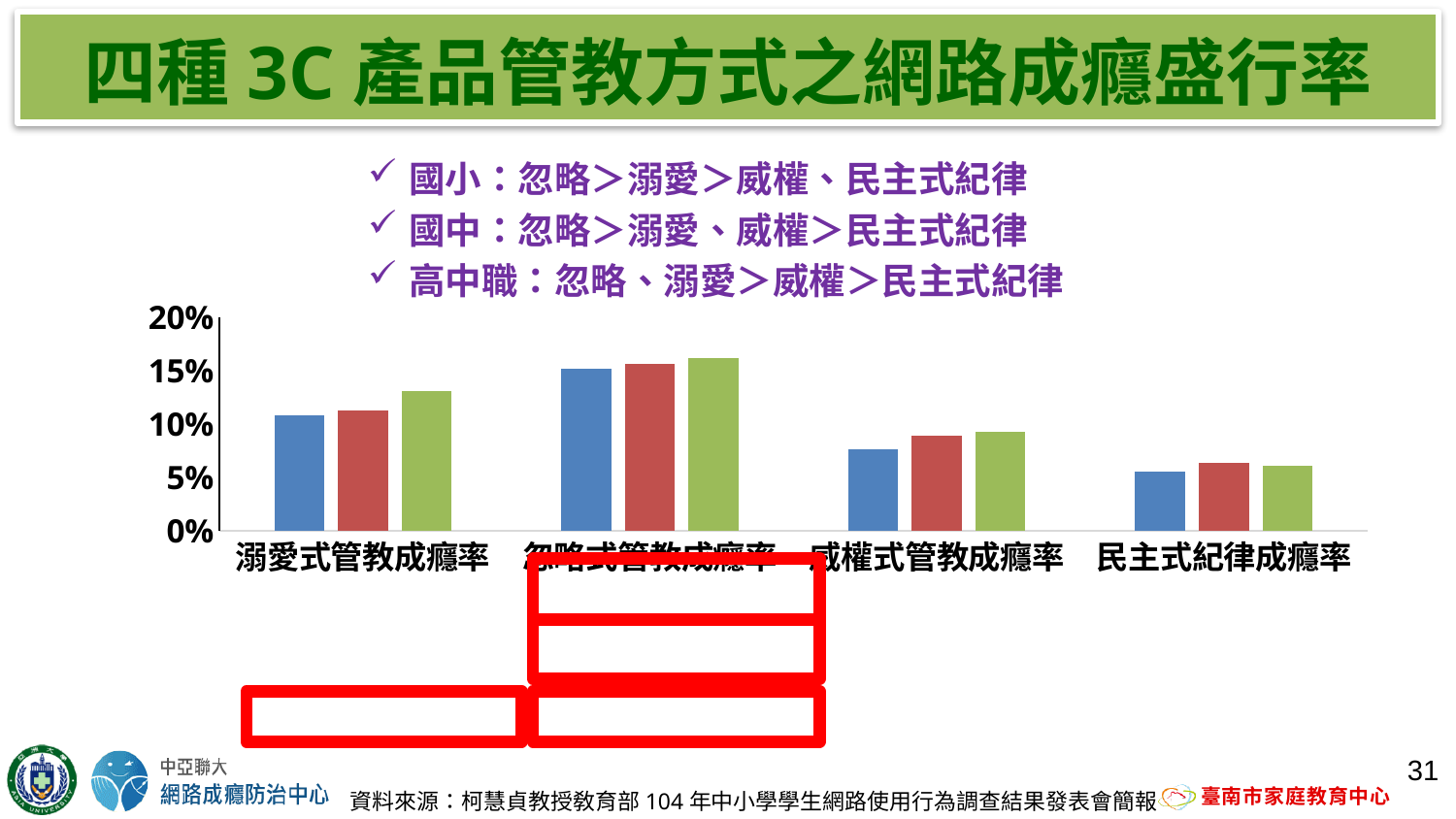
Is the red bar for 民主式紀律成癮率 greater or less than 10%? less Is the green bar for 溺愛式管教成癮率 greater or less than 15%? less Which category has the highest bars in the chart? 忽略式管教成癮率 Which is larger: the green bar for 忽略式管教成癮率 or the green bar for 威權式管教成癮率? 忽略式管教成癮率 Which category has the lowest bars in the chart? 民主式紀律成癮率 What is the title shown at the top of the slide above the chart? 四種 3C 產品管教方式之網路成癮盛行率 How many bars are plotted for each category in the chart? 3 How many categories are shown on the x axis of the chart? 4 What kind of chart is shown on the slide? bar chart Is the green bar for 忽略式管教成癮率 greater or less than 15%? greater